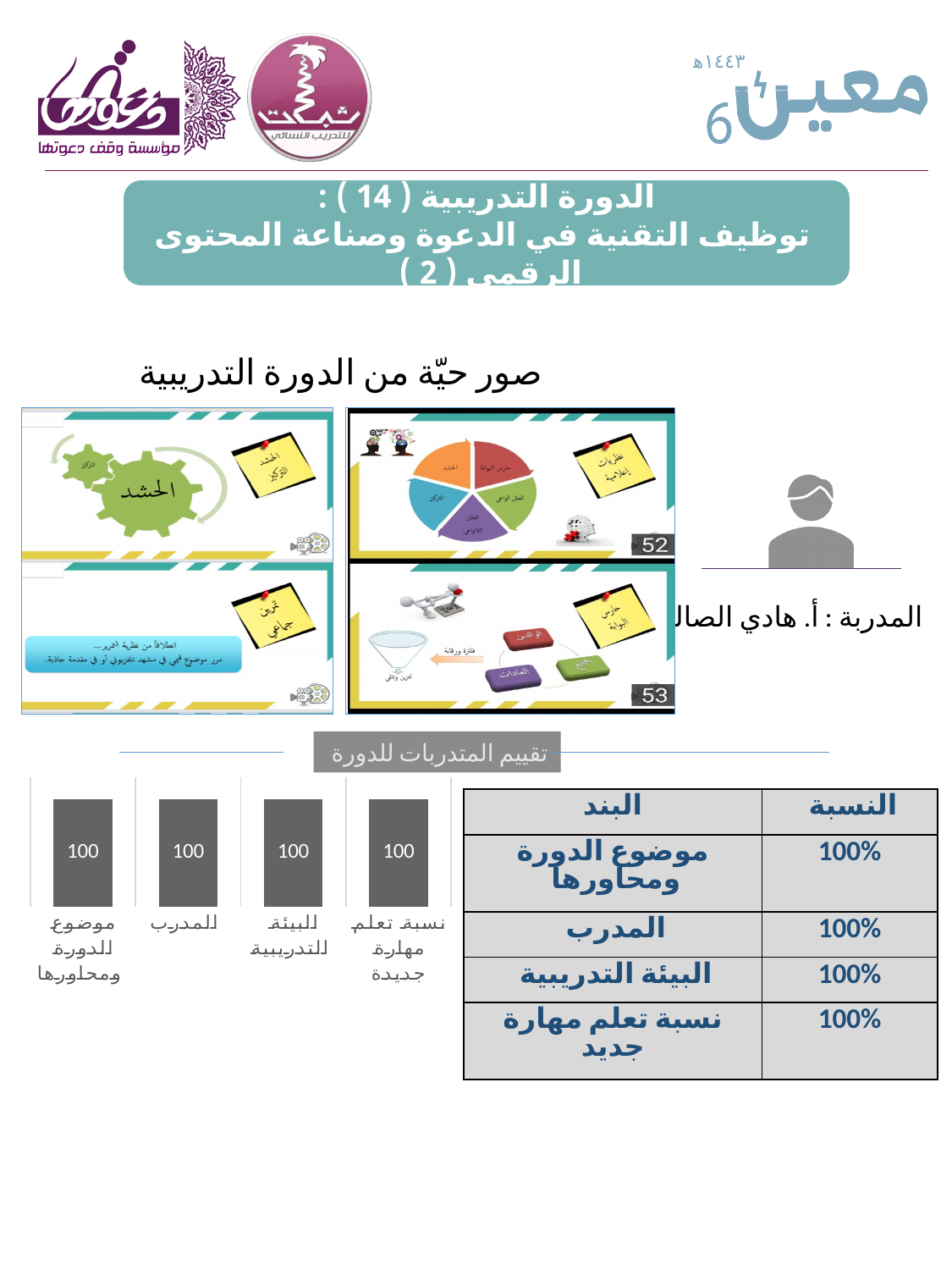
What kind of chart is shown on the slide? bar chart What colour are the bars in the chart? grey What is the difference between the values for المدرب and البيئة التدريبية? 0 What is the value of the bar for المدرب? 100 How many bars are shown in the chart? 4 What is the heading shown above the chart? تقييم المتدربات للدورة What is the value of the bar for موضوع الدورة ومحاورها? 100 What is the value of the bar for نسبة تعلم مهارة جديدة? 100 Do the bar values change from one category to the next across the chart? No, all bars are 100 What is the value of the bar for البيئة التدريبية? 100